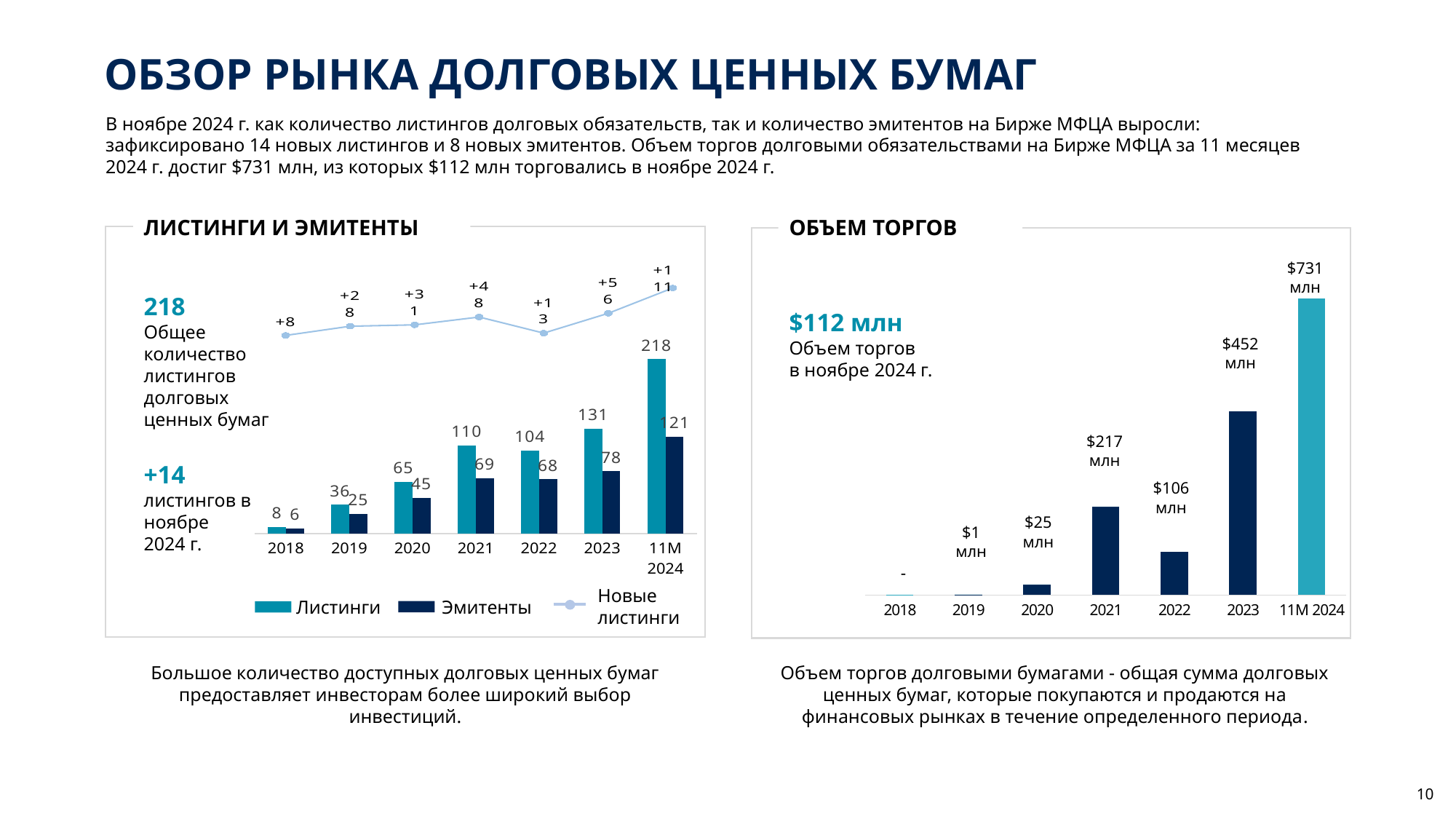
What kind of chart is the "ОБЪЕМ ТОРГОВ" chart? bar chart In the "ЛИСТИНГИ И ЭМИТЕНТЫ" chart, what is the value of Листинги for 2021? 110 In the "ОБЪЕМ ТОРГОВ" chart, what is the value for 2020? $25 млн In the "ЛИСТИНГИ И ЭМИТЕНТЫ" chart, is the value of Листинги for 2022 larger or smaller than for 2021? smaller In the "ОБЪЕМ ТОРГОВ" chart, how many categories are shown on the x axis? 7 In the "ЛИСТИНГИ И ЭМИТЕНТЫ" chart, which category has the highest value of Листинги? 11M 2024 In the "ЛИСТИНГИ И ЭМИТЕНТЫ" chart, what is the difference between Листинги and Эмитенты in 11M 2024? 97 In the "ЛИСТИНГИ И ЭМИТЕНТЫ" chart, how many series does the legend list? 3 In the "ОБЪЕМ ТОРГОВ" chart, what is the difference between the values for 11M 2024 and 2023? $279 млн In the "ОБЪЕМ ТОРГОВ" chart, what is the value for 2023? $452 млн In the "ЛИСТИНГИ И ЭМИТЕНТЫ" chart, what is the value of Эмитенты for 2023? 78 In the "ЛИСТИНГИ И ЭМИТЕНТЫ" chart, what is the value of Новые листинги for 2022? +13